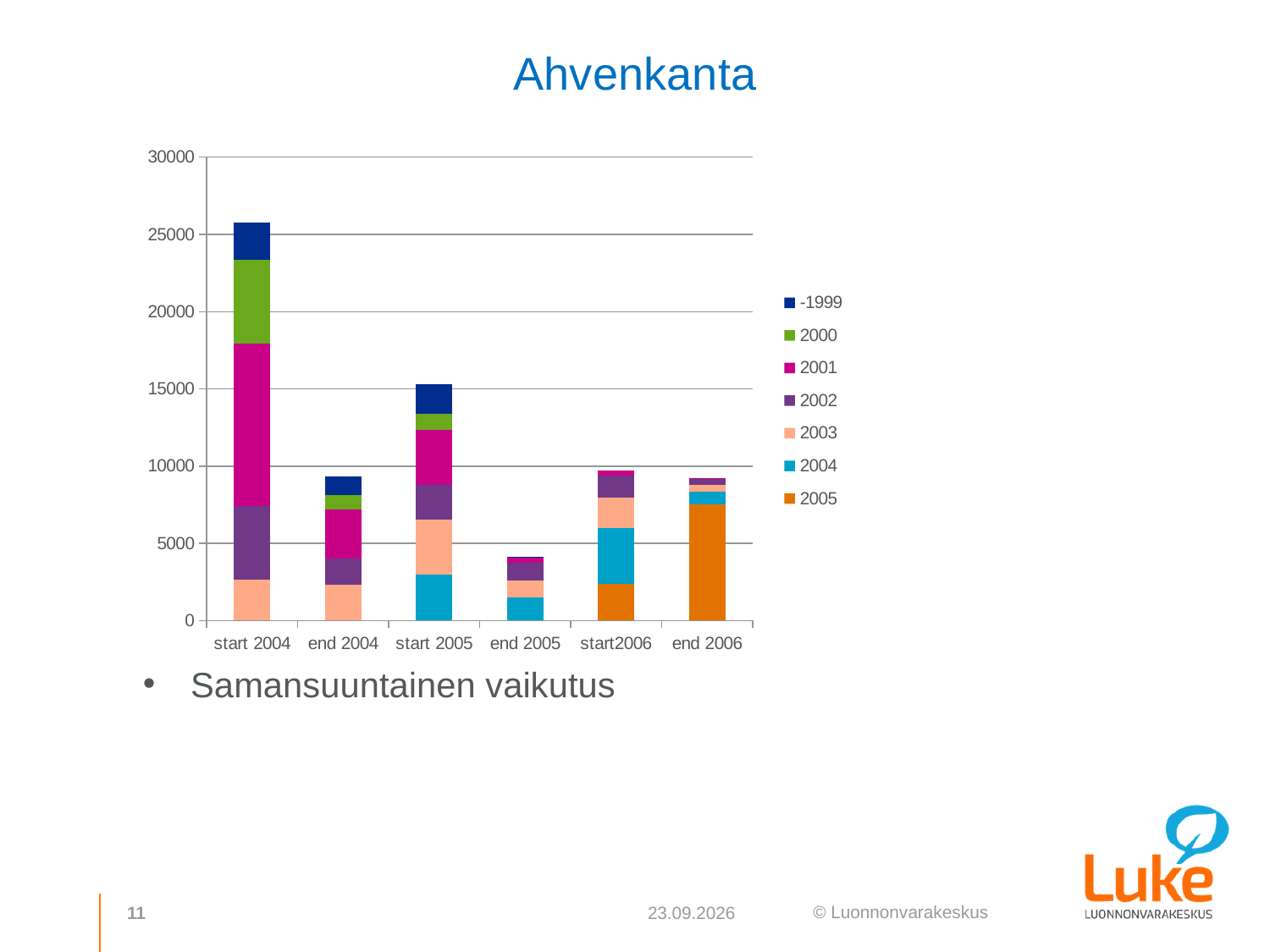
Which category has the shortest stacked bar? end 2005 Which has the larger total, start 2005 or end 2005? start 2005 Which category has the tallest stacked bar? start 2004 What is the title of the chart? Ahvenkanta Is the total for end 2004 greater or less than 10000? less How many series does the chart's legend list? 7 Which series is shown in orange in the legend? 2005 Is the total for end 2005 greater or less than 5000? less Is the total for start 2004 greater or less than 20000? greater How many categories are shown on the x axis of the chart? 6 What kind of chart is shown on the slide? stacked bar chart